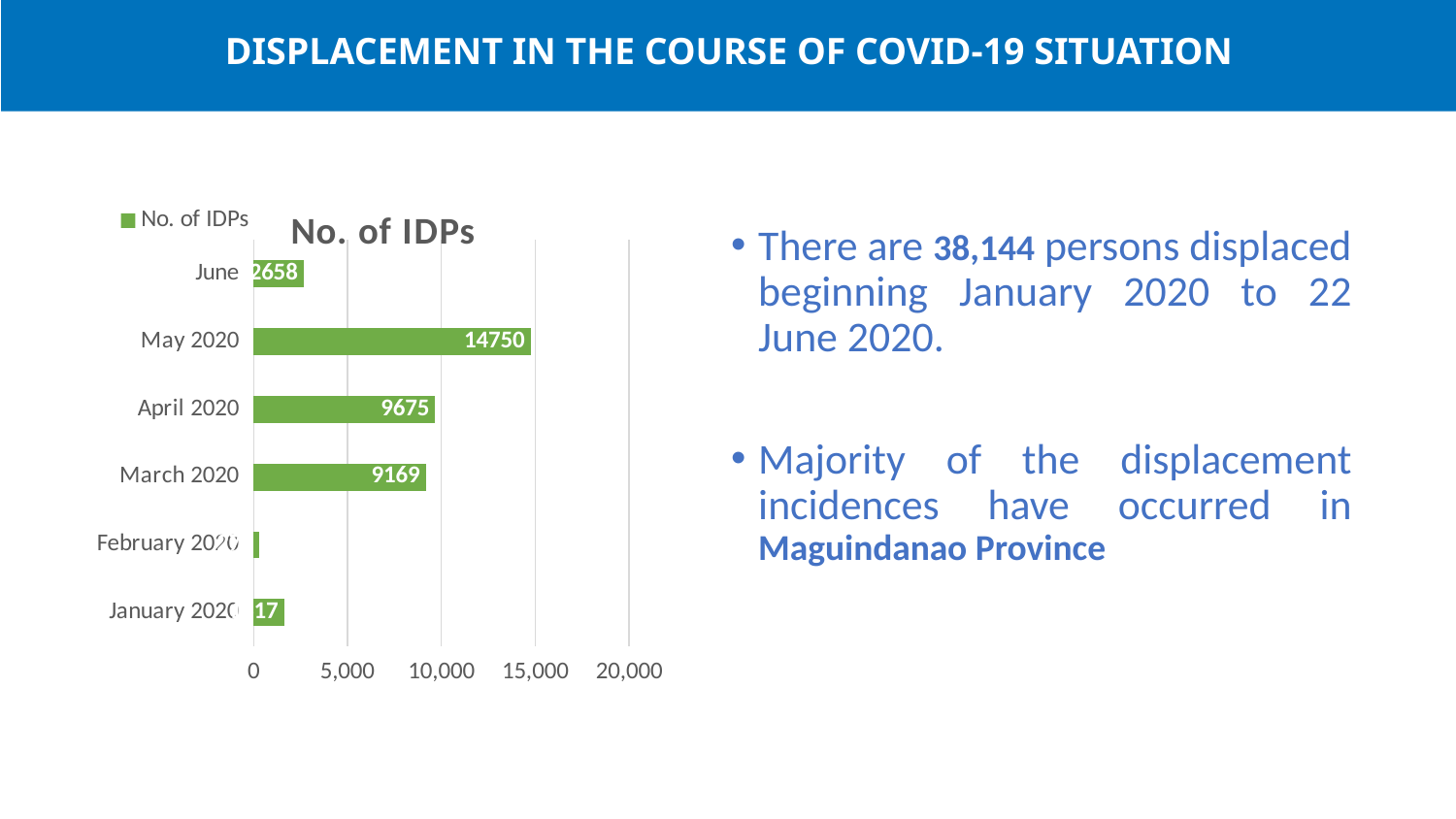
What is the number of IDPs for June? 2658 What is the difference in the number of IDPs between May 2020 and April 2020? 5075 How many months are shown in the chart? 6 What type of chart is shown on the slide? bar chart Which month has the highest number of IDPs? May 2020 What is the number of IDPs for March 2020? 9169 Is the number of IDPs for May 2020 greater or less than 10,000? greater What is the number of IDPs for April 2020? 9675 Which has more IDPs, April 2020 or March 2020? April 2020 What is the number of IDPs for May 2020? 14750 How many series does the legend list? 1 Which month has the lowest number of IDPs? February 2020